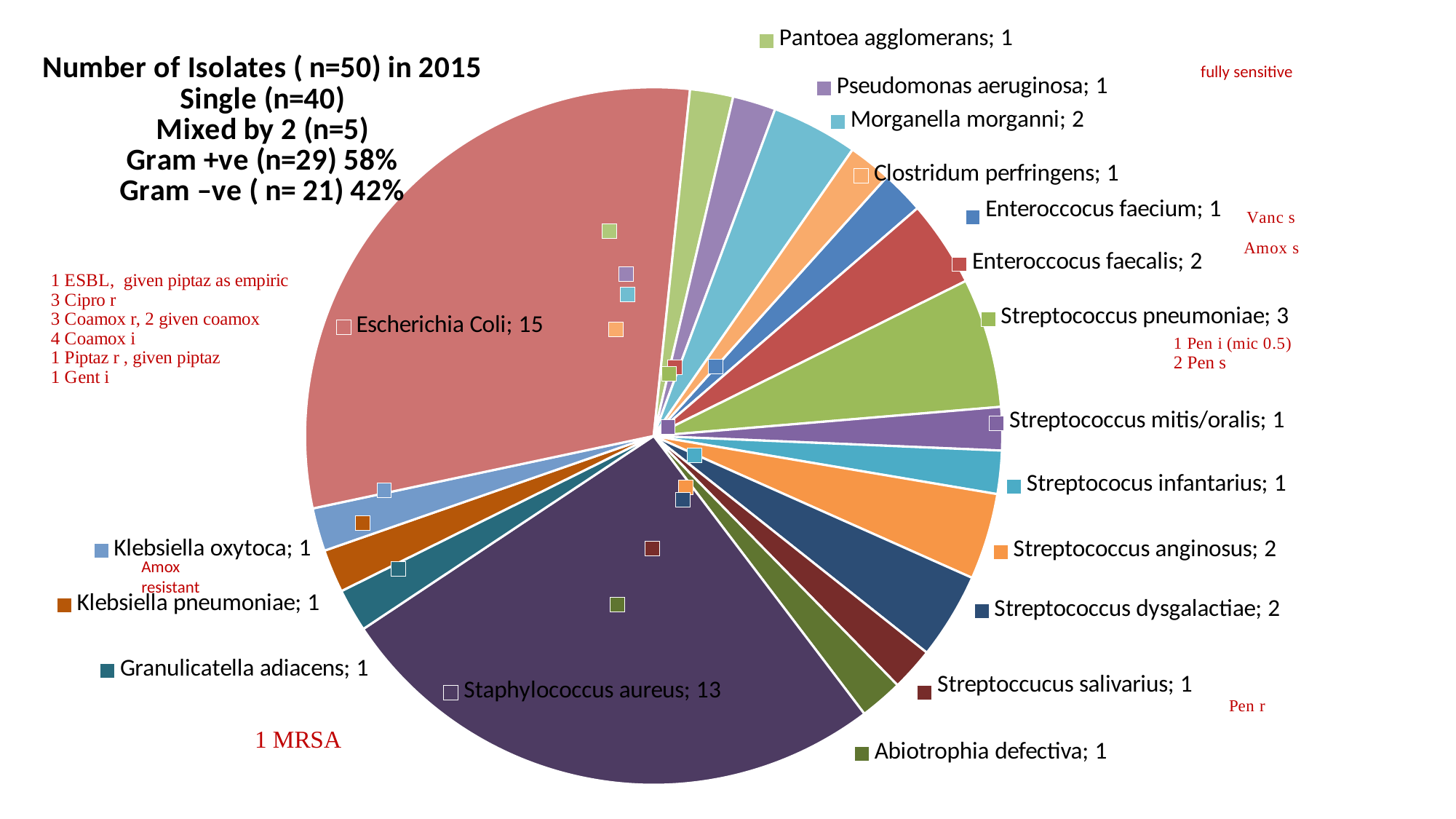
Which organism has the largest slice of the pie? Escherichia Coli What kind of chart is shown on the slide? pie chart What share of the total isolates does Staphylococcus aureus represent? 26% How many isolates are shown for Staphylococcus aureus? 13 Which has more isolates, Streptococcus pneumoniae or Streptococcus anginosus? Streptococcus pneumoniae What is the value for Streptococcus pneumoniae? 3 What is the value for Morganella morganni? 2 How many isolates are shown for Escherichia Coli? 15 What is the difference between the number of Escherichia Coli isolates and Staphylococcus aureus isolates? 2 How many organism categories are shown in the pie chart? 18 What year is given in the chart title? 2015 What share of the total isolates does Escherichia Coli represent? 30%